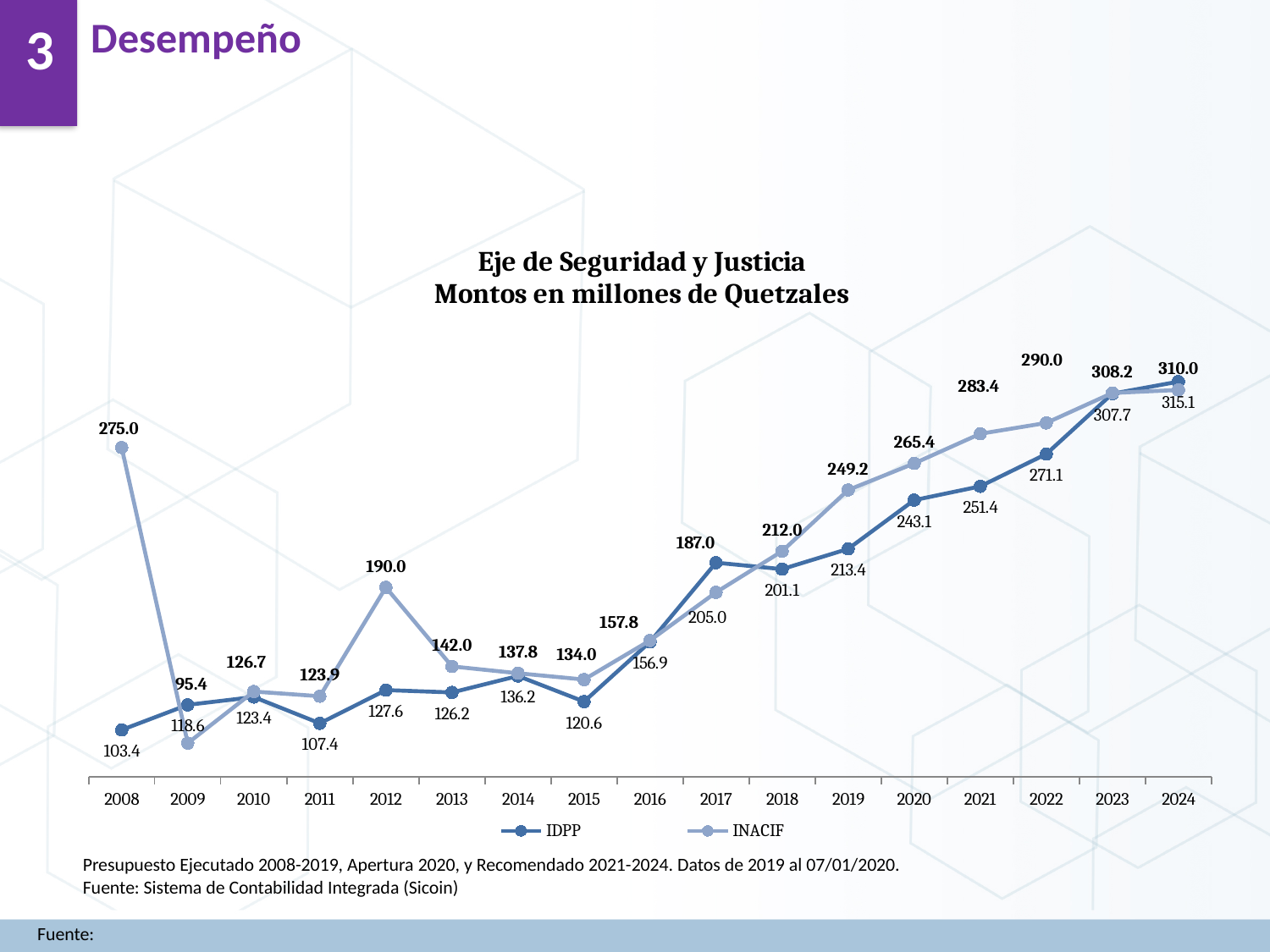
How many years are shown on the x axis? 17 What is the difference between the INACIF and IDPP values in 2008? 171.6 What is the value for INACIF in 2008? 275.0 How many series does the legend list? 2 What is the value for INACIF in 2012? 190.0 What type of chart is shown on the slide? Line chart In which year is the IDPP value highest? 2024 In which year is the INACIF value lowest? 2009 In 2012, which series has the larger value, IDPP or INACIF? INACIF What is the value for IDPP in 2022? 271.1 Does the IDPP series rise or fall from 2015 to 2024? Rise What is the value for IDPP in 2008? 103.4